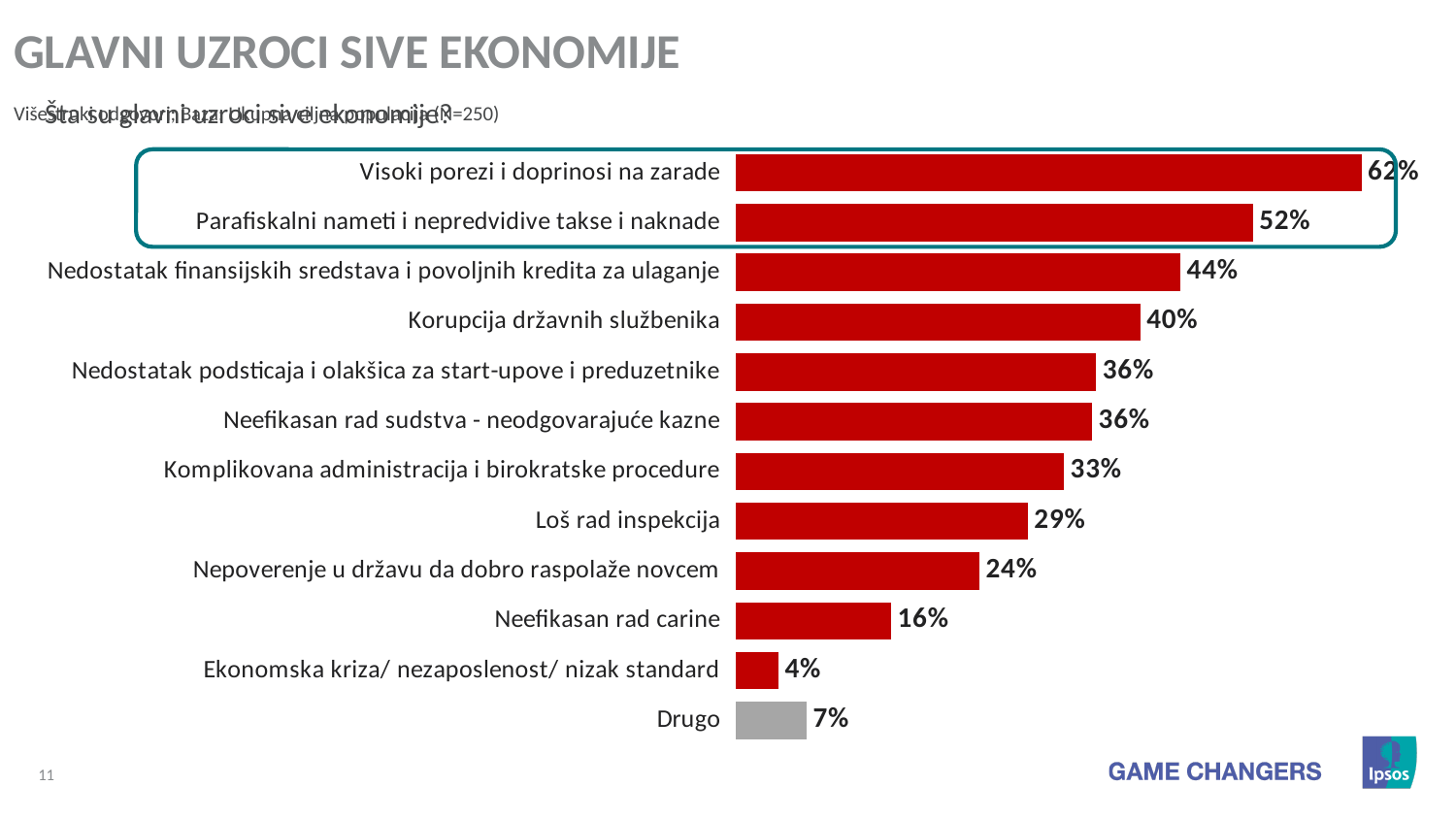
What is the difference between "Loš rad inspekcija" and "Nepoverenje u državu da dobro raspolaže novcem"? 5% What percentage is shown for "Neefikasan rad carine"? 16% What percentage is shown for "Visoki porezi i doprinosi na zarade"? 62% Which is larger: the value for "Komplikovana administracija i birokratske procedure" or for "Loš rad inspekcija"? Komplikovana administracija i birokratske procedure What kind of chart is shown on the slide? Bar chart What is the title of the slide? GLAVNI UZROCI SIVE EKONOMIJE How many categories are shown in the chart? 12 What value is shown for "Korupcija državnih službenika"? 40% What value is shown for "Drugo"? 7% Which category has the highest value? Visoki porezi i doprinosi na zarade Which category has the lowest value? Ekonomska kriza/ nezaposlenost/ nizak standard What is the difference between the values for "Visoki porezi i doprinosi na zarade" and "Parafiskalni nameti i nepredvidive takse i naknade"? 10%